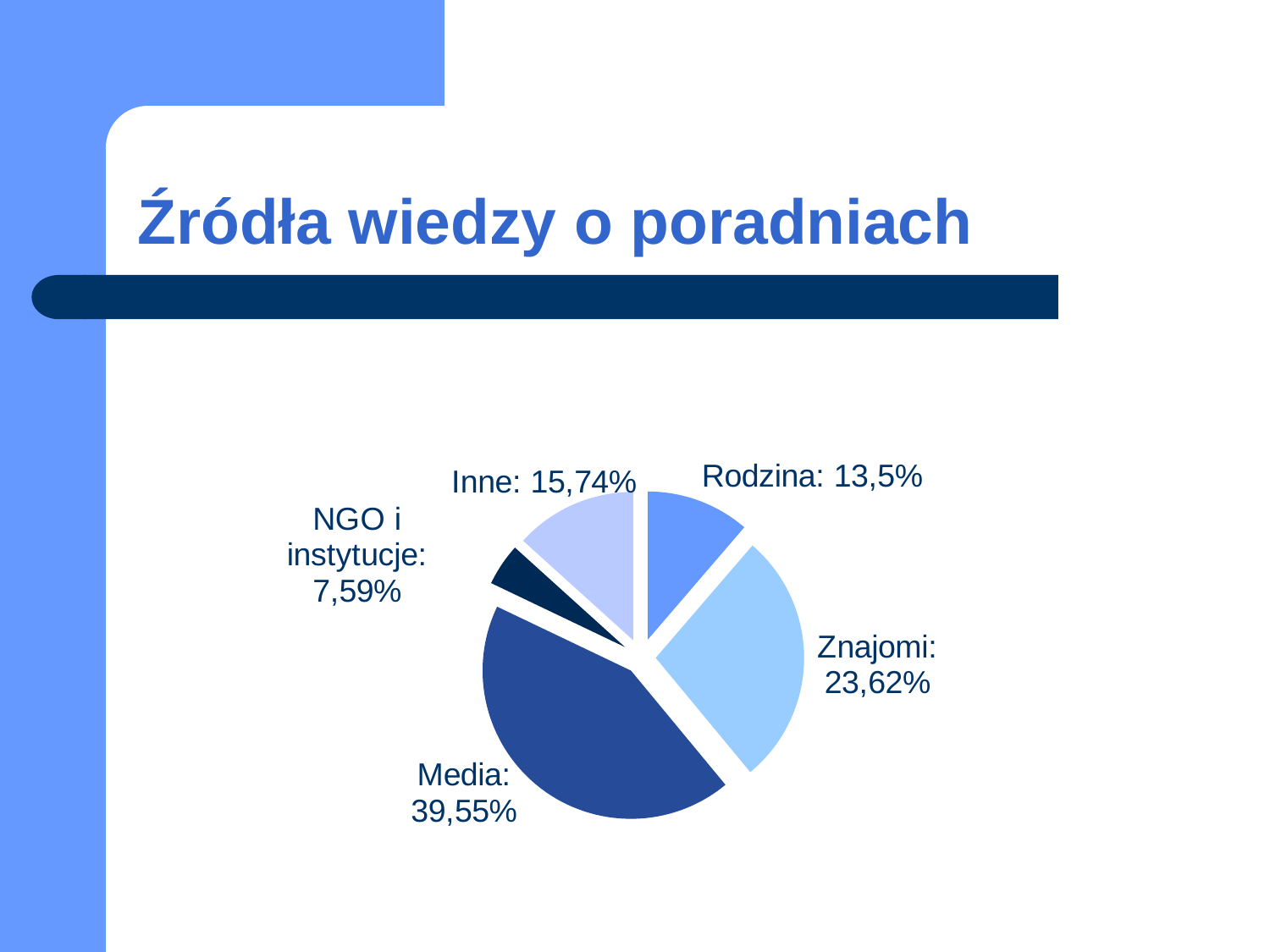
What is the value for NGO i instytucje? 7,59% What is the title of the slide containing the chart? Źródła wiedzy o poradniach What is the value for Inne? 15,74% Which category has the smallest share of the pie? NGO i instytucje What is the value for Media? 39,55% What type of chart is shown on the slide? pie chart What is the value for Znajomi? 23,62% What is the difference between the share for Media and the share for Znajomi? 15,93% What is the value for Rodzina? 13,5% Which is larger, the share for Inne or the share for Rodzina? Inne How many slices does the pie chart have? 5 Which category has the largest share of the pie? Media